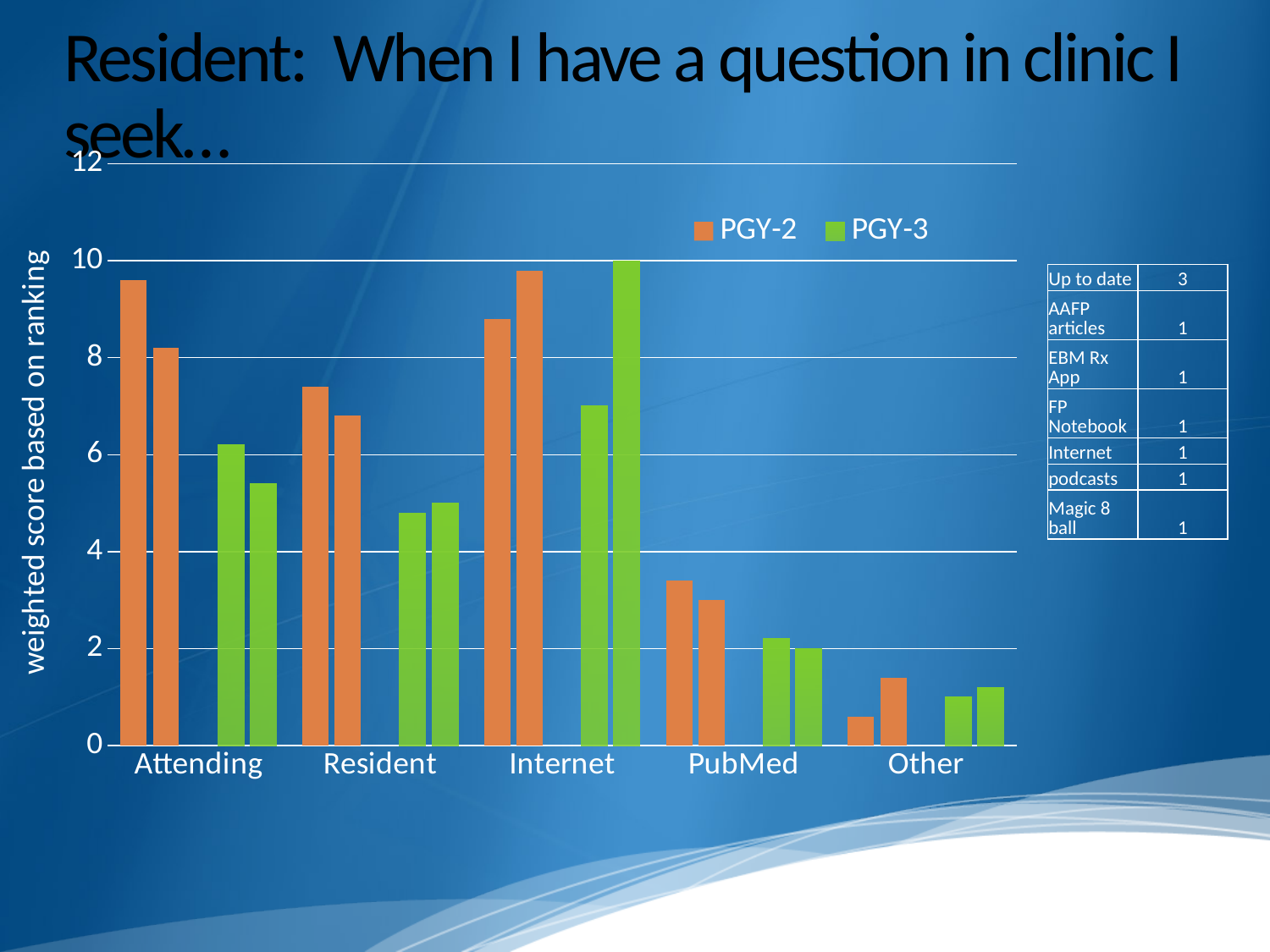
How many series does the chart's legend list? 2 How many categories are shown along the x axis of the chart? 5 Which colour represents the PGY-2 series in the chart? orange What is the label on the chart's y axis? weighted score based on ranking Is the tallest bar for PubMed greater or less than 4? less Is the tallest bar for Resident greater or less than 6? greater What kind of chart is shown on the slide? bar chart Which category has taller bars, Attending or PubMed? Attending Is the tallest bar for Attending greater or less than 8? greater Which category has the lowest bars in the chart? Other Which category has taller bars, Resident or Other? Resident